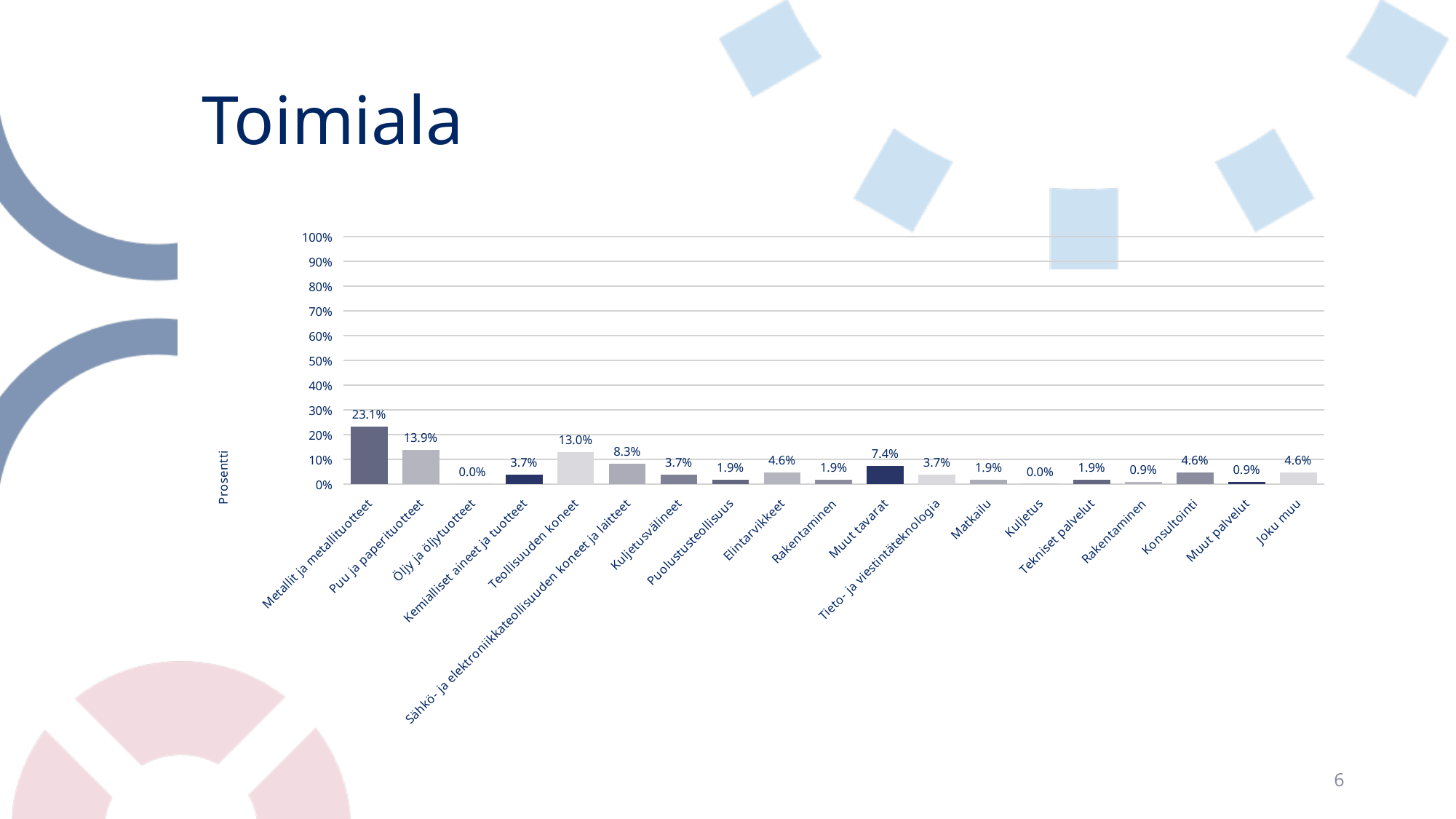
Is the value for Metallit ja metallituotteet greater or less than 20%? greater What kind of chart is shown on the slide? bar chart How many categories are shown on the x axis? 19 What is the value for Teollisuuden koneet? 13.0% What is the title of the slide? Toimiala What is the value for Metallit ja metallituotteet? 23.1% Which category has the highest value? Metallit ja metallituotteet What is the value for Sähkö- ja elektroniikkateollisuuden koneet ja laitteet? 8.3% What is the difference between Metallit ja metallituotteet and Puu ja paperituotteet? 9.2% Which is larger, Puu ja paperituotteet or Teollisuuden koneet? Puu ja paperituotteet What is the value for Muut tavarat? 7.4% What is the label of the vertical axis? Prosentti